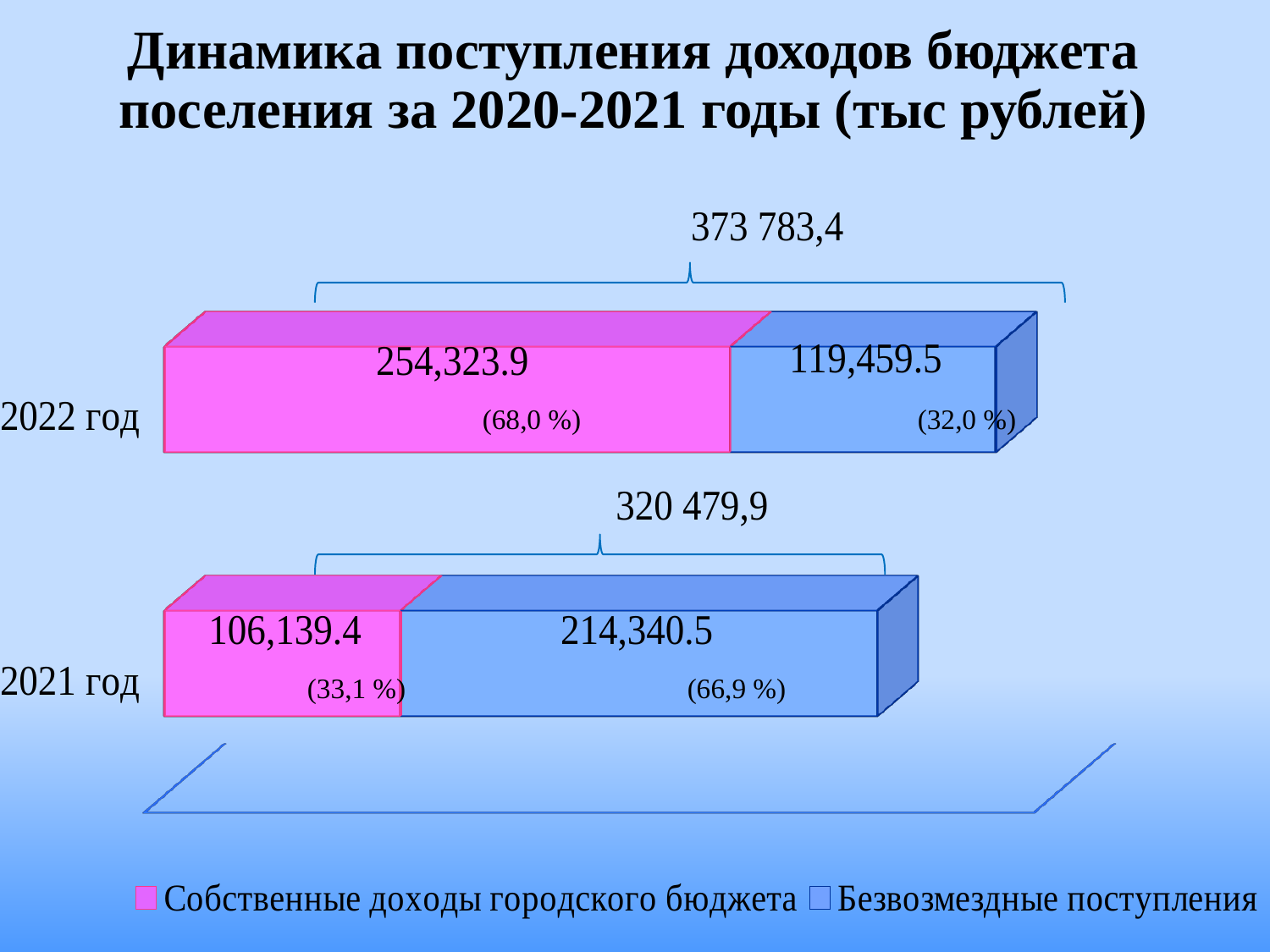
What percentage share is shown for Безвозмездные поступления in 2021 год? 66,9 % Which year has the larger value for Собственные доходы городского бюджета, 2022 год or 2021 год? 2022 год How many series does the legend list? 2 What is the total shown above the bar for 2021 год? 320 479,9 What is the total shown above the bar for 2022 год? 373 783,4 What is the value of Безвозмездные поступления for 2022 год? 119,459.5 What is the value of Собственные доходы городского бюджета for 2021 год? 106,139.4 What percentage share is shown for Собственные доходы городского бюджета in 2022 год? 68,0 % What kind of chart is shown on the slide? Stacked bar chart What is the value of Собственные доходы городского бюджета for 2022 год? 254,323.9 What is the value of Безвозмездные поступления for 2021 год? 214,340.5 Which year has the larger value for Безвозмездные поступления, 2022 год or 2021 год? 2021 год